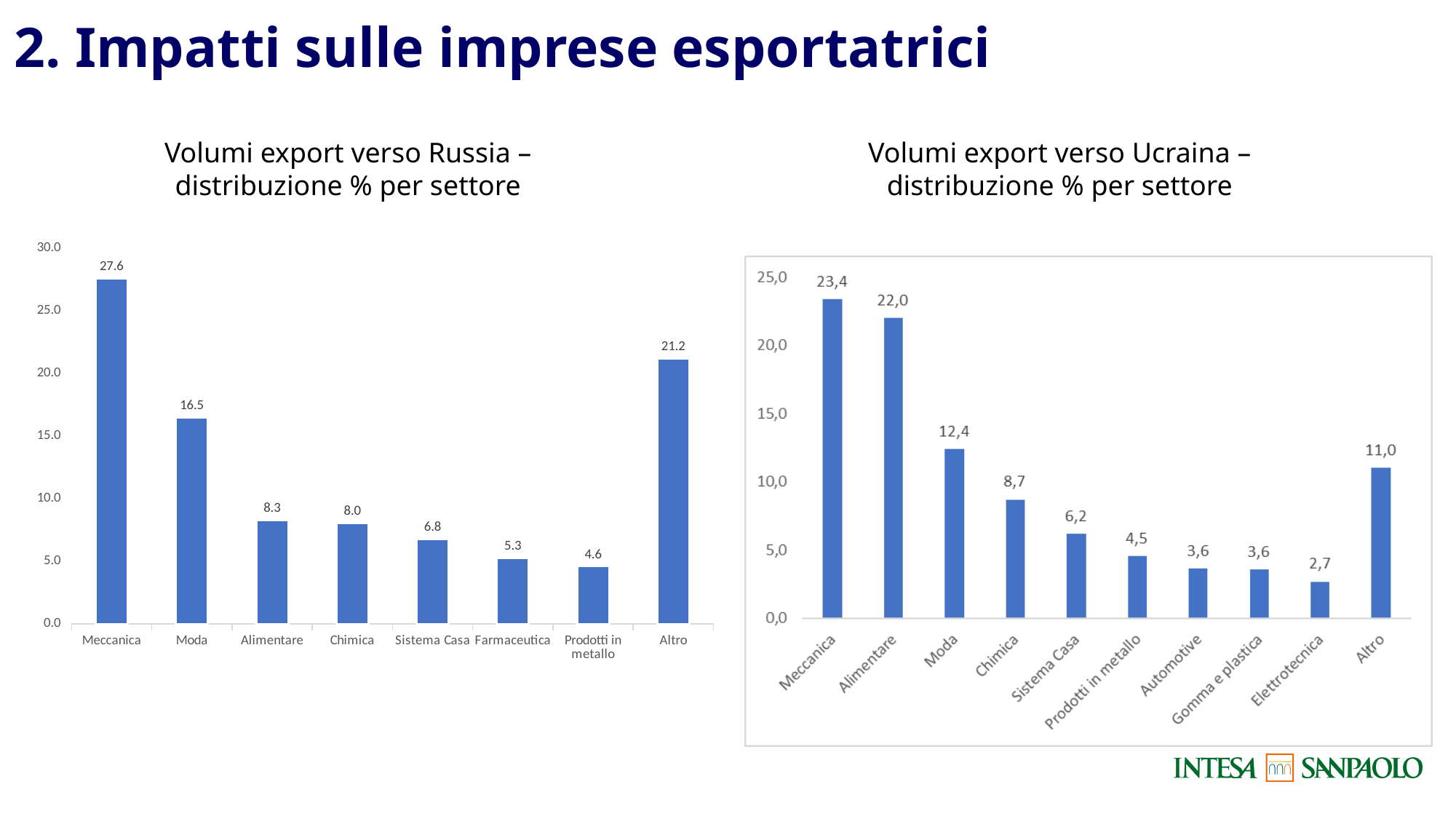
In the 'Volumi export verso Russia' chart, what is the value for Meccanica? 27.6 In the 'Volumi export verso Russia' chart, which sector has the lowest value? Prodotti in metallo In the 'Volumi export verso Russia' chart, which is larger, Alimentare or Chimica? Alimentare What kind of chart is the 'Volumi export verso Ucraina' chart? Bar chart In the 'Volumi export verso Ucraina' chart, what is the value for Alimentare? 22,0 In the 'Volumi export verso Ucraina' chart, what is the difference between Moda and Chimica? 3,7 In the 'Volumi export verso Ucraina' chart, which sector has the highest value? Meccanica In the 'Volumi export verso Ucraina' chart, which sector has the lowest value? Elettrotecnica In the 'Volumi export verso Ucraina' chart, is the value for Altro greater or less than 10,0? greater How many sectors are shown in the 'Volumi export verso Russia' chart? 8 In the 'Volumi export verso Russia' chart, what is the difference between Meccanica and Moda? 11.1 How many sectors are shown in the 'Volumi export verso Ucraina' chart? 10